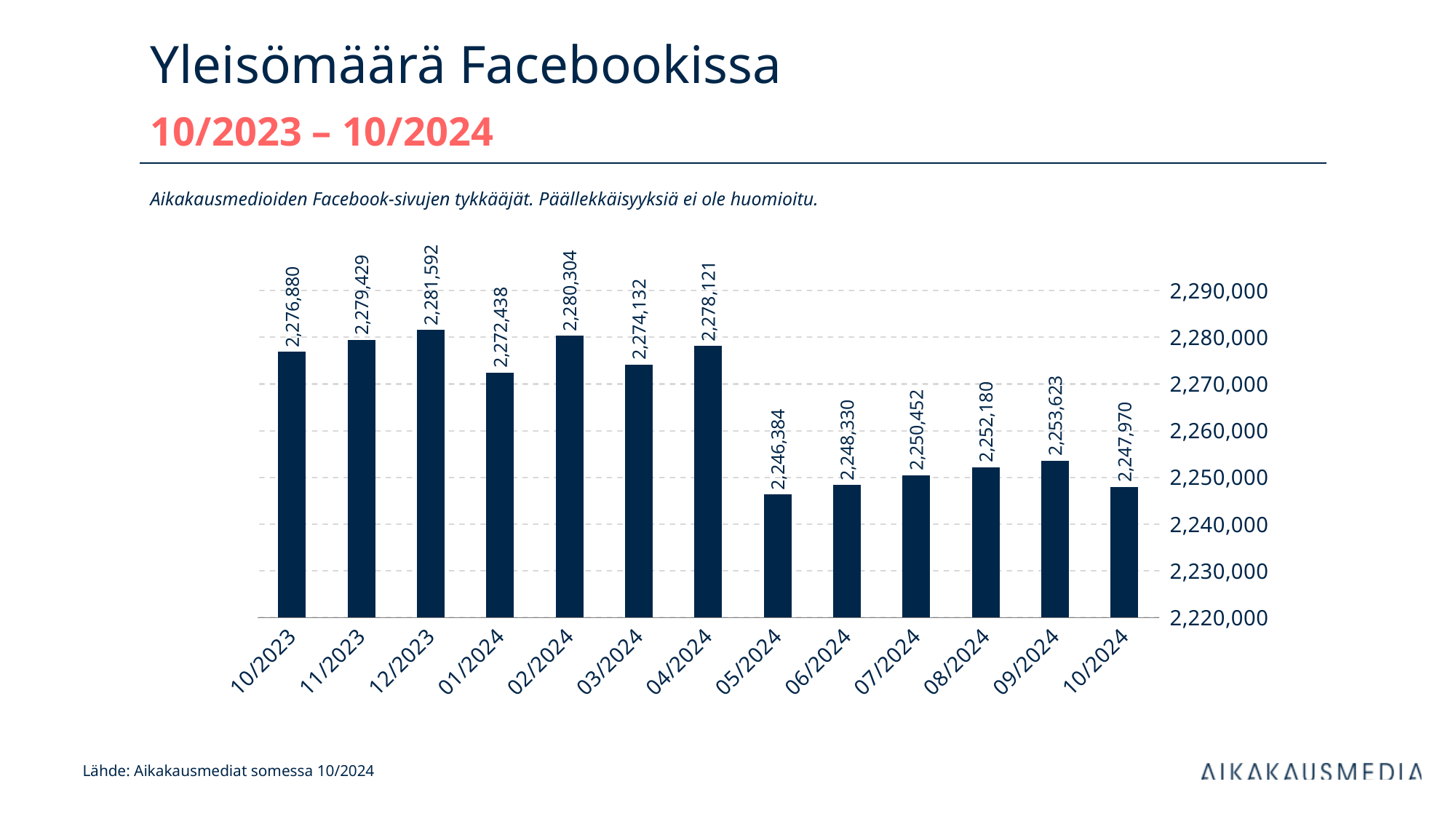
What is the title of the chart on the slide? Yleisömäärä Facebookissa Is the value for 09/2024 greater or less than 2,260,000? less Which is larger, the value for 02/2024 or the value for 04/2024? 02/2024 What is the difference between the values for 10/2023 and 10/2024? 28,910 What is the value shown for 10/2024? 2,247,970 What is the value shown for 05/2024? 2,246,384 What is the difference between the values for 12/2023 and 05/2024? 35,208 What type of chart is shown on the slide? bar chart How many months (bars) are plotted in the chart? 13 What is the Facebook audience value for 12/2023? 2,281,592 Which month has the highest value in the chart? 12/2023 Which month has the lowest value in the chart? 05/2024